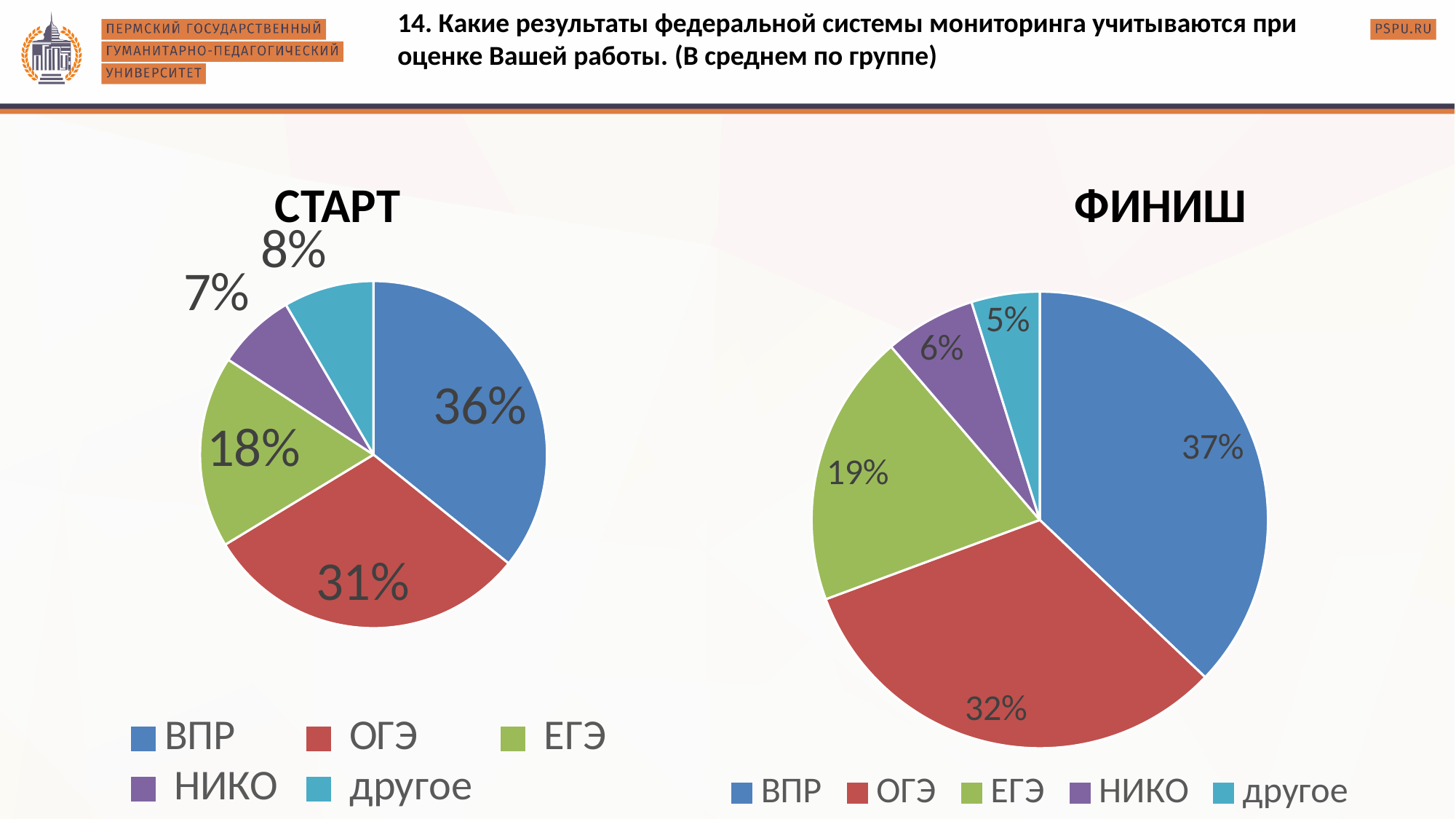
In the СТАРТ chart, which category has the smallest share? НИКО In the ФИНИШ chart, which category has the smallest share? другое In the СТАРТ chart, what share does НИКО have? 7% How many categories does the ФИНИШ chart show? 5 In the ФИНИШ chart, what is the difference between the shares of ВПР and ОГЭ? 5% What type of chart is the СТАРТ chart? Pie chart In the ФИНИШ chart, which colour represents ЕГЭ? Green In the ФИНИШ chart, what share does другое have? 5% In the СТАРТ chart, which category has the largest share? ВПР In the ФИНИШ chart, what share does ОГЭ have? 32% In the СТАРТ chart, which is larger, the share of ЕГЭ or the share of другое? ЕГЭ In the СТАРТ chart, what share does ВПР have? 36%